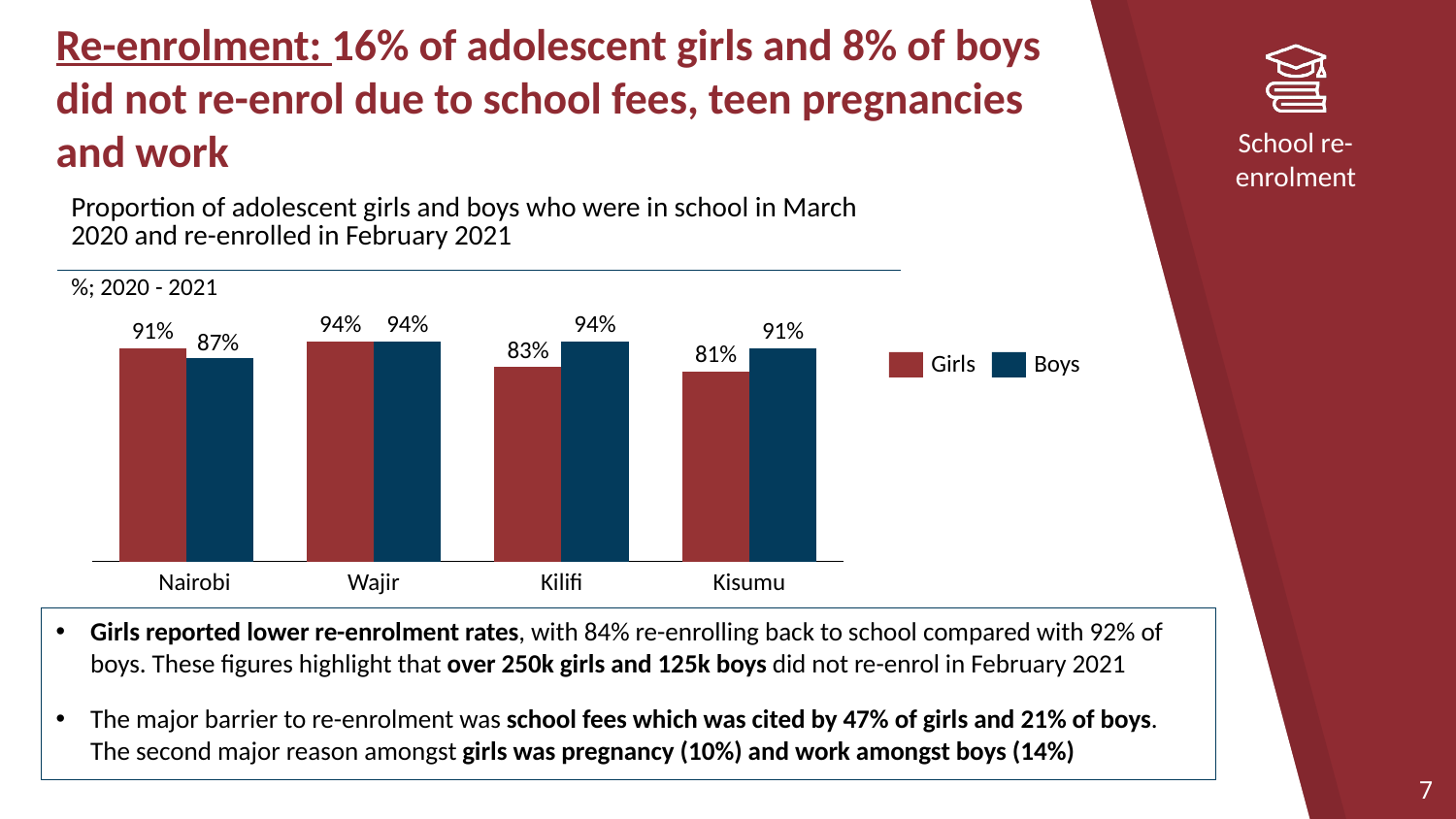
What type of chart is shown on the slide? Bar chart In Nairobi, which group has the higher re-enrolment rate, girls or boys? Girls What is the re-enrolment rate for boys in Kisumu? 91% How many series does the chart legend list? 2 Which county has the lowest re-enrolment rate for boys? Nairobi Which county has the lowest re-enrolment rate for girls? Kisumu What is the difference between the boys' and girls' re-enrolment rates in Kilifi? 11% Which county has the highest re-enrolment rate for girls? Wajir What is the re-enrolment rate for girls in Nairobi? 91% How many counties are shown on the x axis of the chart? 4 What is the re-enrolment rate for girls in Kilifi? 83% What colour represents Boys in the chart legend? Dark blue